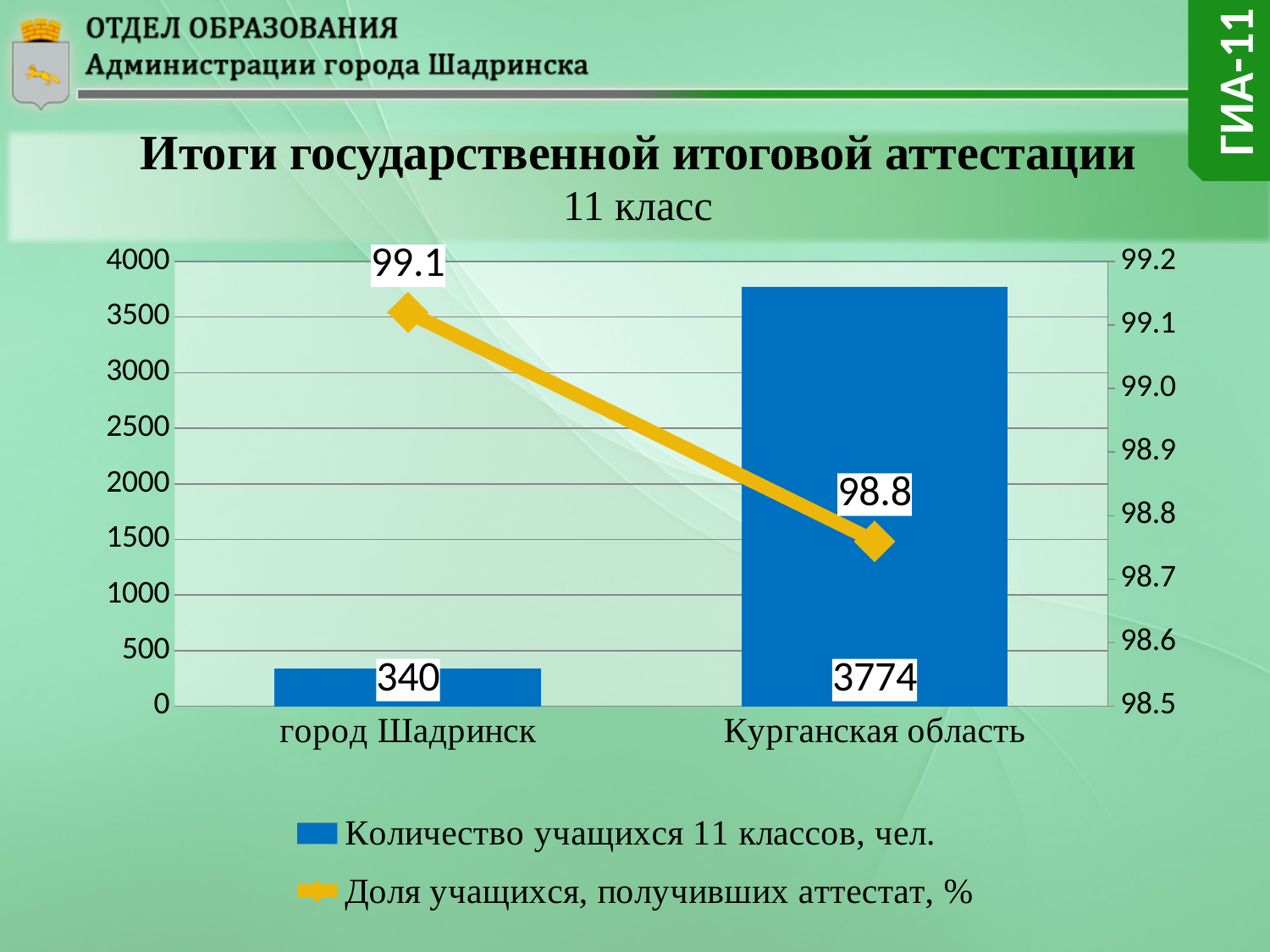
What is the share of students who received a certificate (Доля учащихся, получивших аттестат, %) for город Шадринск? 99.1 How many series does the chart legend list? 2 Which category has the higher number of 11th-grade students? Курганская область Which category has the lower share of students who received a certificate? Курганская область What is the share of students who received a certificate (Доля учащихся, получивших аттестат, %) for Курганская область? 98.8 What is the difference in the number of 11th-grade students between Курганская область and город Шадринск? 3434 What is the difference in the share of students who received a certificate between город Шадринск and Курганская область? 0.3 Does the share of students who received a certificate rise or fall from город Шадринск to Курганская область? fall How many categories are shown on the x axis of the chart? 2 What is the number of 11th-grade students (Количество учащихся 11 классов, чел.) for город Шадринск? 340 Is the share of students who received a certificate higher for город Шадринск or for Курганская область? город Шадринск What is the number of 11th-grade students (Количество учащихся 11 классов, чел.) for Курганская область? 3774